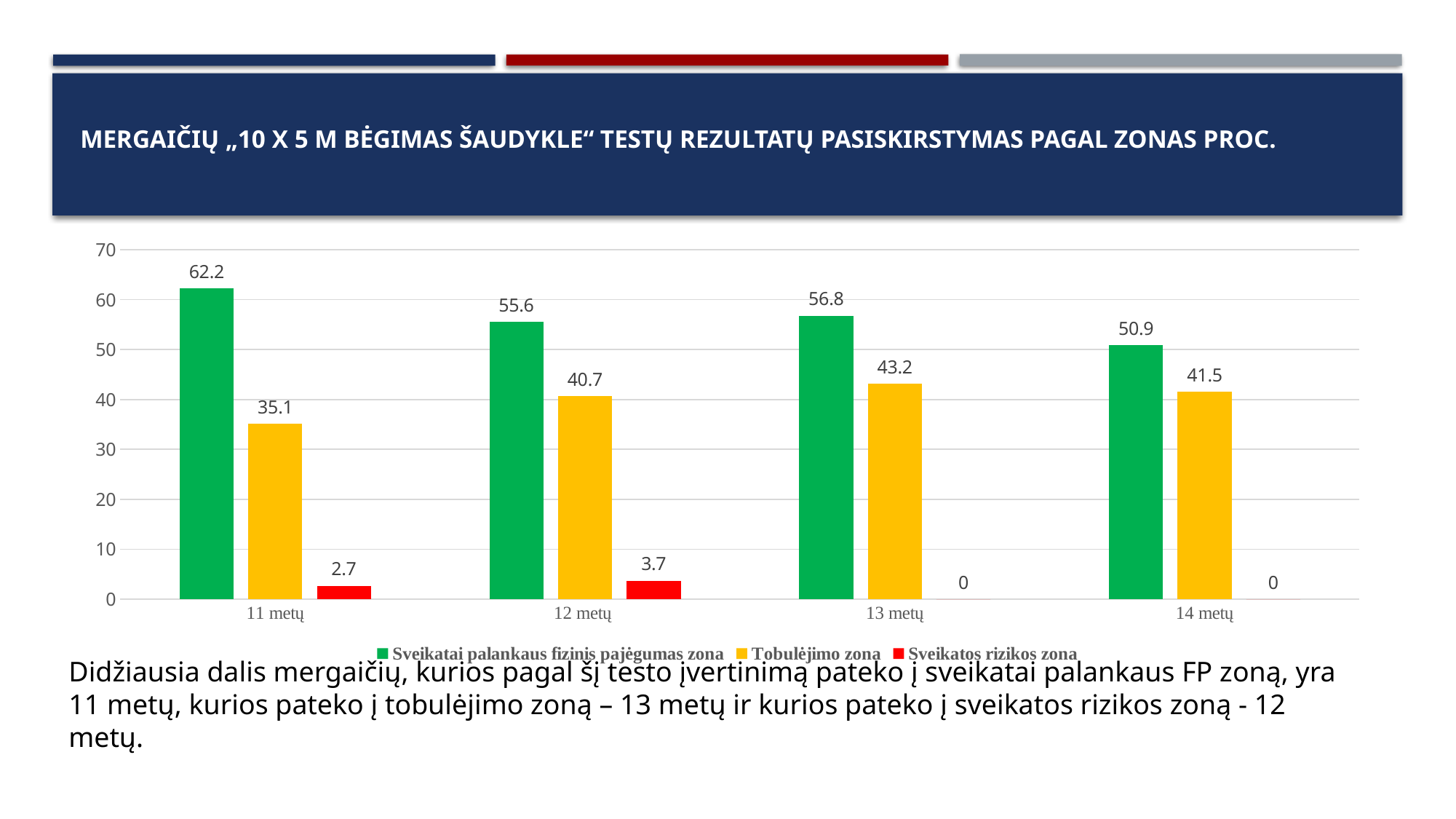
Which colour represents 'Sveikatos rizikos zona' in the chart? Red What is the value for 'Sveikatos rizikos zona' for 12 metų? 3.7 Which age group has the highest value for 'Sveikatai palankaus fizinis pajėgumas zona'? 11 metų How many age groups are shown on the x axis? 4 What kind of chart is shown on the slide? Bar chart Which is larger: the 'Tobulėjimo zona' value for 12 metų or for 14 metų? 14 metų What is the difference between the 'Sveikatai palankaus fizinis pajėgumas zona' value and the 'Tobulėjimo zona' value for 14 metų? 9.4 How many series does the legend list? 3 What is the value for 'Sveikatai palankaus fizinis pajėgumas zona' for 11 metų? 62.2 What is the value for 'Tobulėjimo zona' for 13 metų? 43.2 What is the value for 'Sveikatos rizikos zona' for 14 metų? 0 Which age group has the lowest value for 'Tobulėjimo zona'? 11 metų